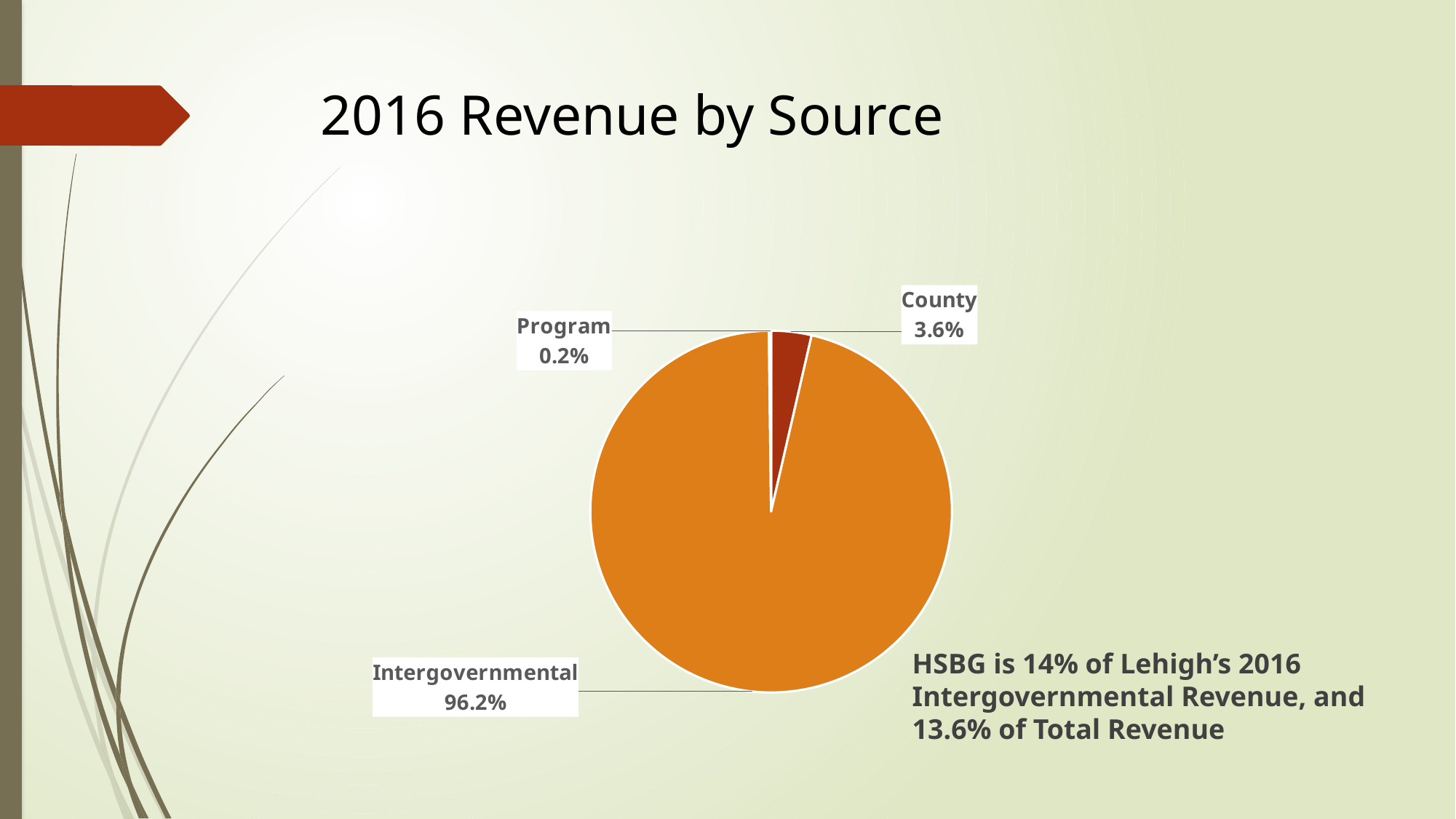
What is the difference in percentage points between the Intergovernmental share and the County share? 92.6 What is the difference in percentage points between the County share and the Program share? 3.4 What share of 2016 revenue comes from County sources? 3.6% What share of 2016 revenue comes from Intergovernmental sources? 96.2% What is the title of the slide containing the pie chart? 2016 Revenue by Source Which is larger, the County share or the Program share? County Which revenue source has the largest share of the pie? Intergovernmental According to the text beside the chart, what percentage of Total Revenue is HSBG? 13.6% Which revenue source has the smallest share of the pie? Program How many slices does the pie chart have? 3 What share of 2016 revenue comes from Program sources? 0.2% What type of chart is shown on the slide? pie chart